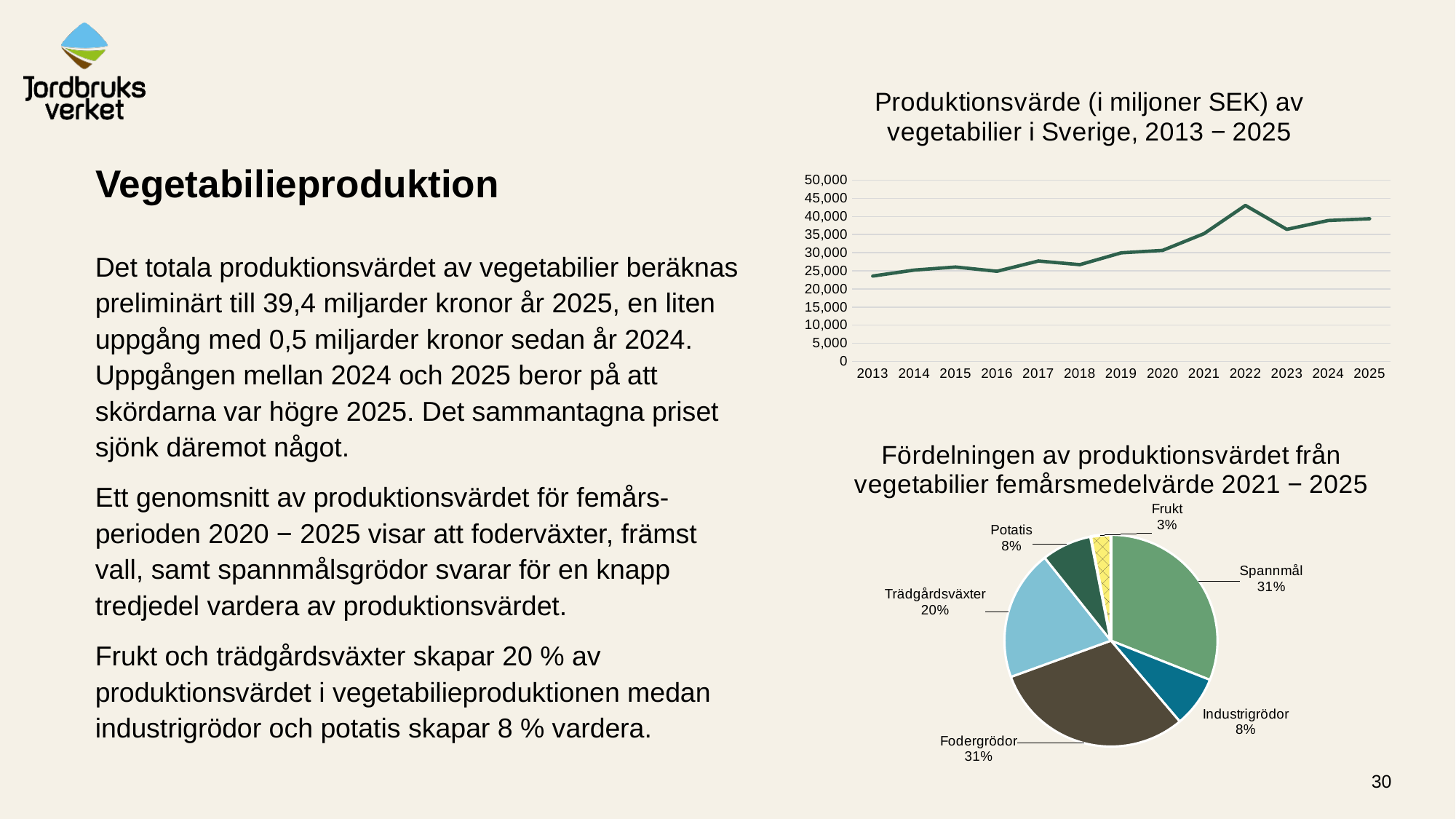
In the bottom pie chart 'Fördelningen av produktionsvärdet från vegetabilier femårsmedelvärde 2021 − 2025', what share does Spannmål have? 31% In the top chart 'Produktionsvärde (i miljoner SEK) av vegetabilier i Sverige, 2013 − 2025', is the value for 2022 greater or less than 40,000? greater In the top chart 'Produktionsvärde (i miljoner SEK) av vegetabilier i Sverige, 2013 − 2025', do the values generally rise or fall from 2013 to 2025? rise In the top chart 'Produktionsvärde (i miljoner SEK) av vegetabilier i Sverige, 2013 − 2025', is the value for 2013 greater or less than 25,000? less In the top chart 'Produktionsvärde (i miljoner SEK) av vegetabilier i Sverige, 2013 − 2025', which year has the lowest value? 2013 In the top chart 'Produktionsvärde (i miljoner SEK) av vegetabilier i Sverige, 2013 − 2025', how many years are plotted on the x axis? 13 In the bottom pie chart 'Fördelningen av produktionsvärdet från vegetabilier femårsmedelvärde 2021 − 2025', what is the difference in percentage points between Trädgårdsväxter and Potatis? 12% In the top chart 'Produktionsvärde (i miljoner SEK) av vegetabilier i Sverige, 2013 − 2025', which year has the highest value? 2022 In the bottom pie chart 'Fördelningen av produktionsvärdet från vegetabilier femårsmedelvärde 2021 − 2025', how many categories are shown? 6 In the bottom pie chart 'Fördelningen av produktionsvärdet från vegetabilier femårsmedelvärde 2021 − 2025', which category has the smallest share? Frukt In the bottom pie chart 'Fördelningen av produktionsvärdet från vegetabilier femårsmedelvärde 2021 − 2025', what share does Trädgårdsväxter have? 20% In the top chart 'Produktionsvärde (i miljoner SEK) av vegetabilier i Sverige, 2013 − 2025', what kind of chart is shown? line chart